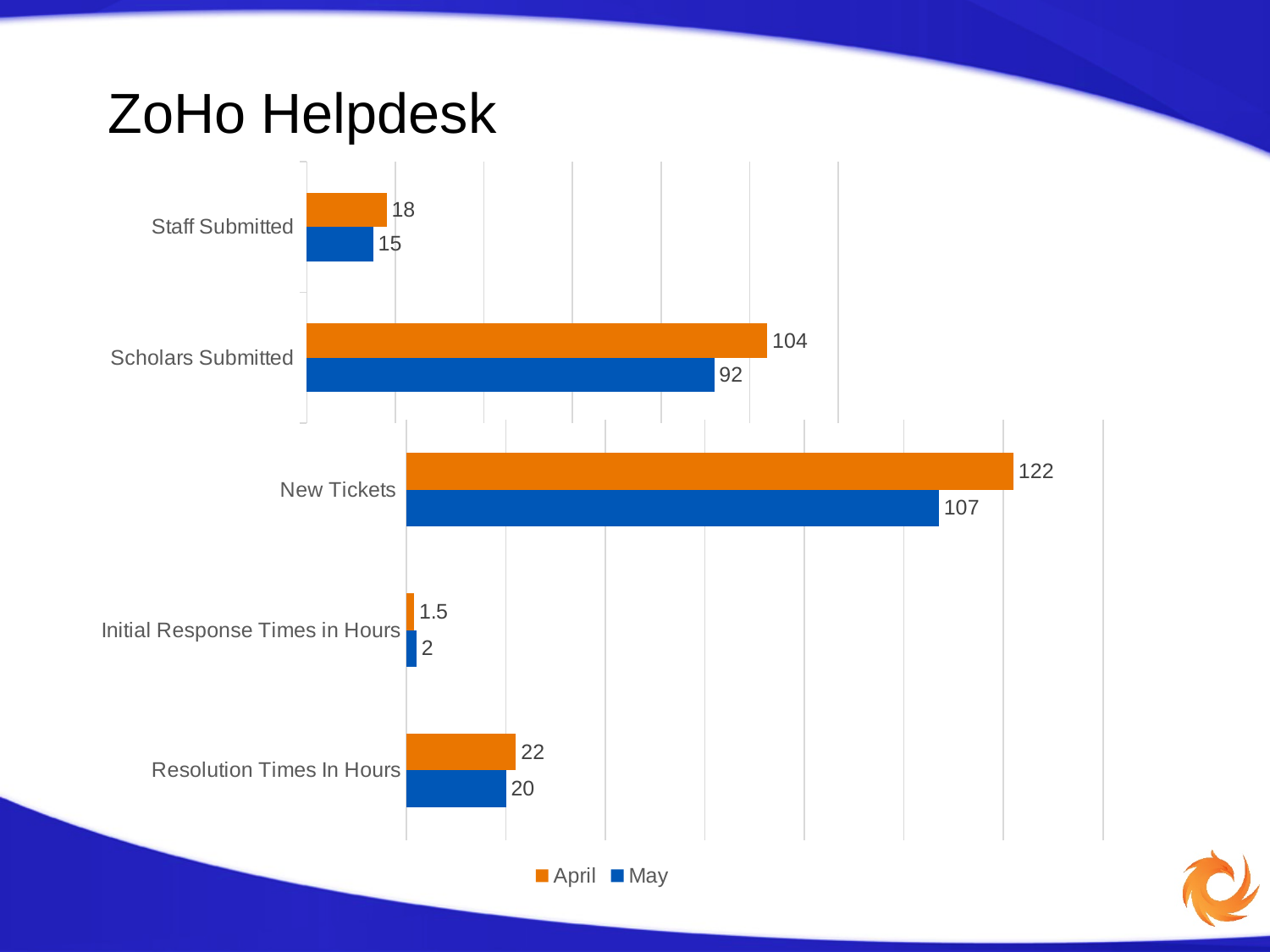
In the lower chart, what is the April value for New Tickets? 122 In the lower chart, what is the May value for Resolution Times In Hours? 20 In the lower chart, what is the May value for New Tickets? 107 In the upper chart, what is the April value for Scholars Submitted? 104 What kind of chart is the lower chart? Bar chart In the upper chart, what is the difference between the April and May values for Scholars Submitted? 12 In the lower chart, what is the difference between the April and May values for New Tickets? 15 In the lower chart, which month has the larger value for Initial Response Times in Hours, April or May? May In the upper chart, what is the May value for Staff Submitted? 15 How many series does the legend of the lower chart list? 2 In the lower chart, which category has the highest April value? New Tickets In the lower chart, what is the April value for Initial Response Times in Hours? 1.5